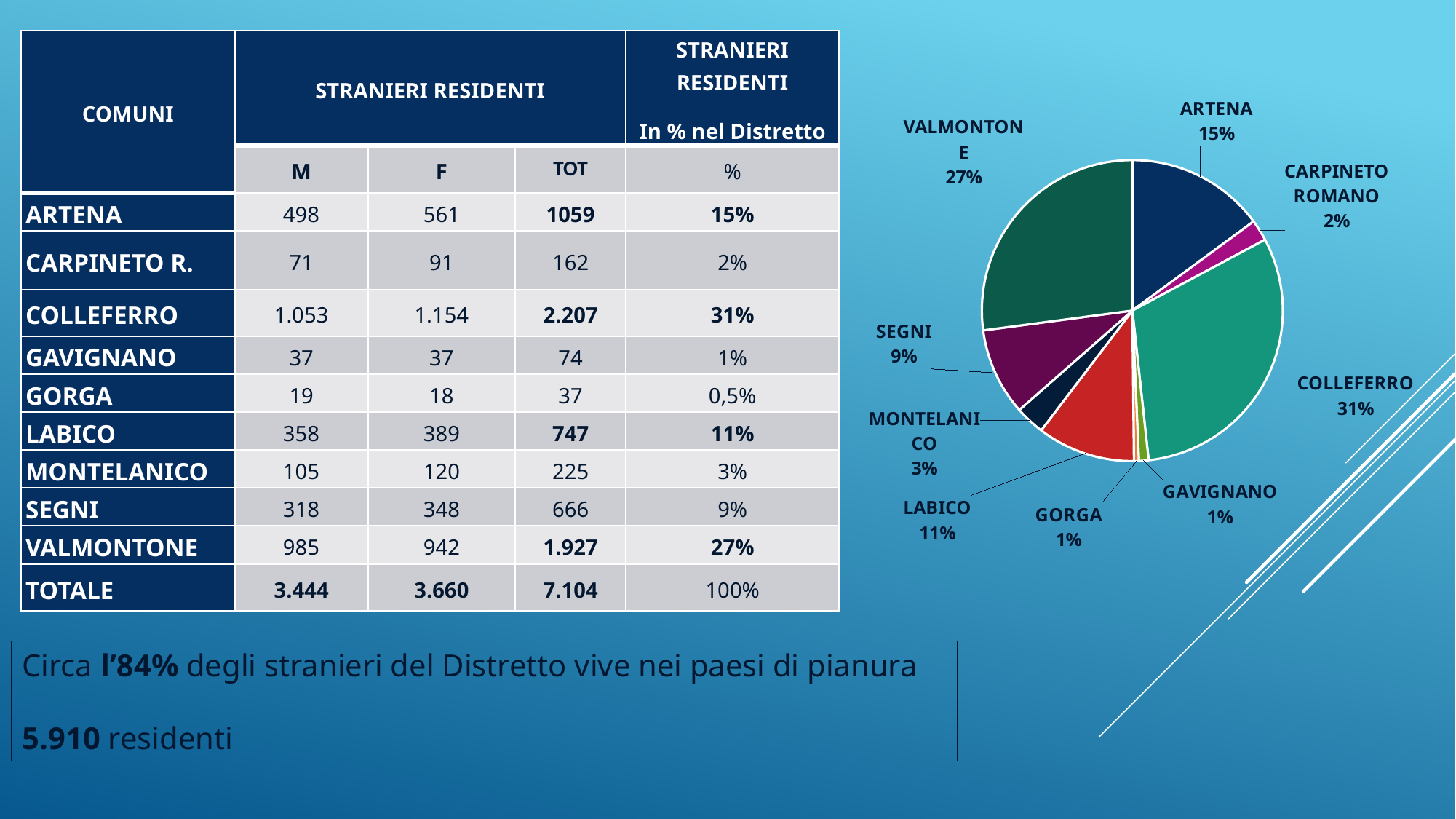
In the pie chart, what share is shown for MONTELANICO? 3% In the pie chart, what share is shown for SEGNI? 9% In the pie chart, what share is shown for CARPINETO ROMANO? 2% How many slices does the pie chart have? 9 In the pie chart, what share is shown for VALMONTONE? 27% In the pie chart, what share is shown for LABICO? 11% Which slice of the pie chart is the largest? COLLEFERRO In the pie chart, what share is shown for COLLEFERRO? 31% In the pie chart, which has a larger share, SEGNI or MONTELANICO? SEGNI What type of chart is shown on the slide? pie chart In the pie chart, what is the difference in percentage points between COLLEFERRO and VALMONTONE? 4 In the pie chart, which has a larger share, ARTENA or LABICO? ARTENA